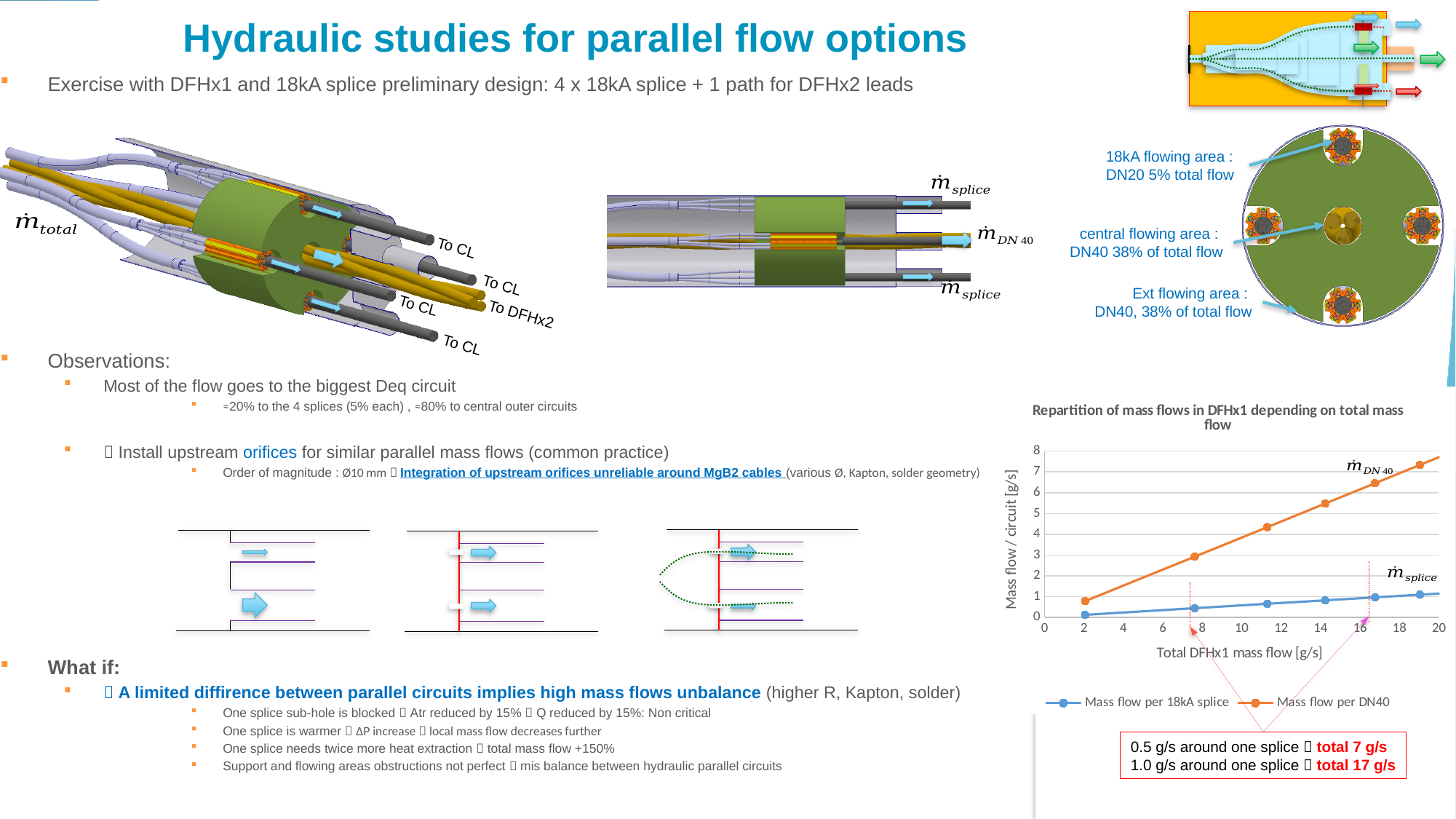
Is the mass flow per DN40 at a total mass flow of 18 g/s greater or less than 6 g/s? greater Does the mass flow per DN40 rise or fall as the total DFHx1 mass flow increases? rise What kind of chart is shown on the slide? line chart What is the title of the chart? Repartition of mass flows in DFHx1 depending on total mass flow Does the mass flow per 18kA splice rise or fall as the total DFHx1 mass flow increases? rise Is the mass flow per DN40 at a total mass flow of 8 g/s greater or less than 2 g/s? greater Which series has the higher values across the chart, mass flow per 18kA splice or mass flow per DN40? Mass flow per DN40 How many series does the chart legend list? 2 Which series is drawn in orange in the chart? Mass flow per DN40 What is the maximum value shown on the y axis of the chart? 8 Is the mass flow per 18kA splice at a total mass flow of 18 g/s greater or less than 2 g/s? less